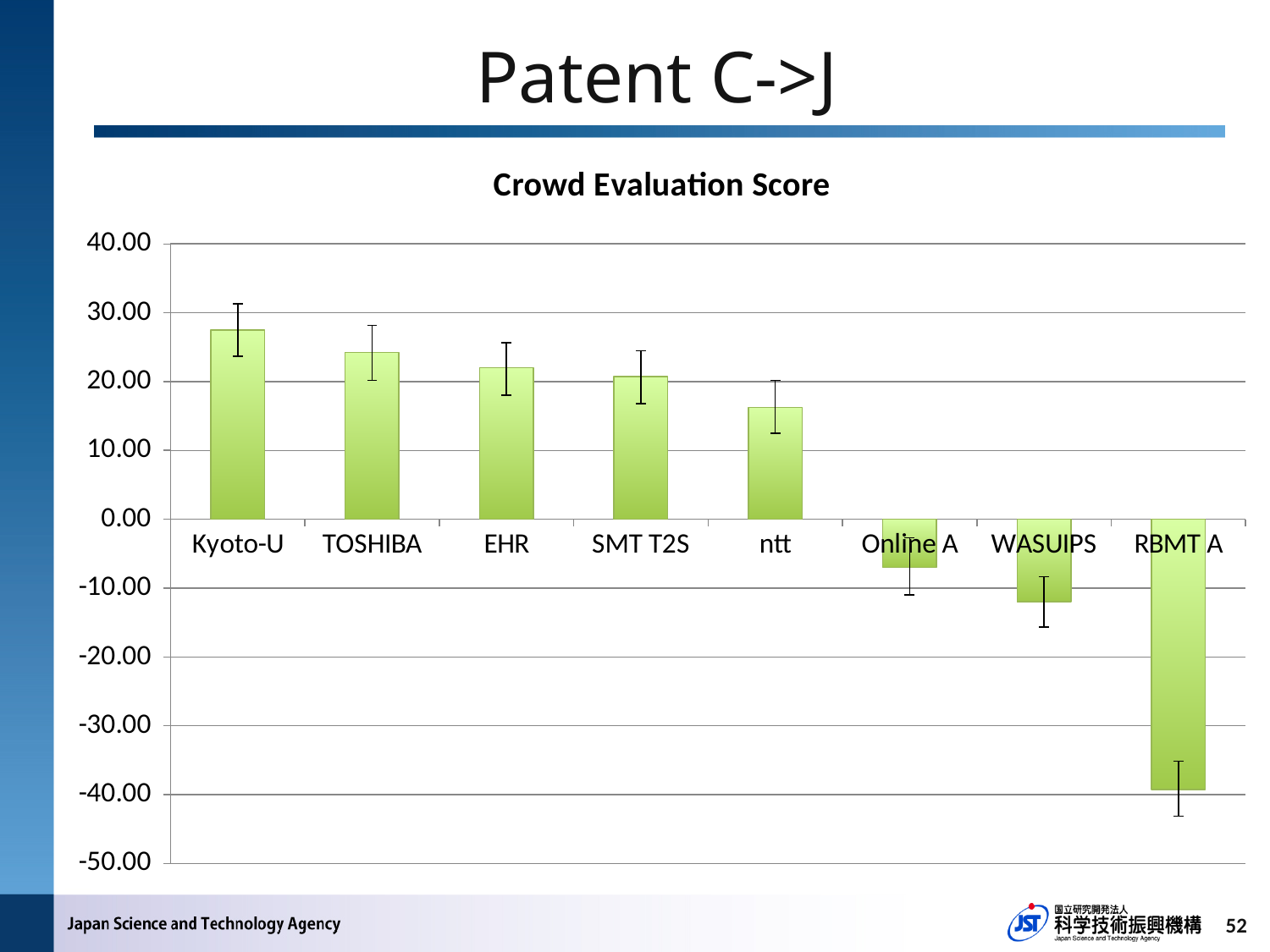
What kind of chart is shown on the slide? bar chart Is the value for Kyoto-U greater or less than 20.00? greater Is the value for ntt greater or less than 20.00? less Which category has the lowest Crowd Evaluation Score? RBMT A Which has a higher Crowd Evaluation Score, TOSHIBA or ntt? TOSHIBA Which has a higher Crowd Evaluation Score, Online A or WASUIPS? Online A What is the title of the chart? Crowd Evaluation Score Do the values rise or fall from left to right along the x axis? fall Which category has the highest Crowd Evaluation Score? Kyoto-U Is the value for RBMT A greater or less than -30.00? less How many categories have a negative Crowd Evaluation Score? 3 How many categories are plotted on the x axis? 8